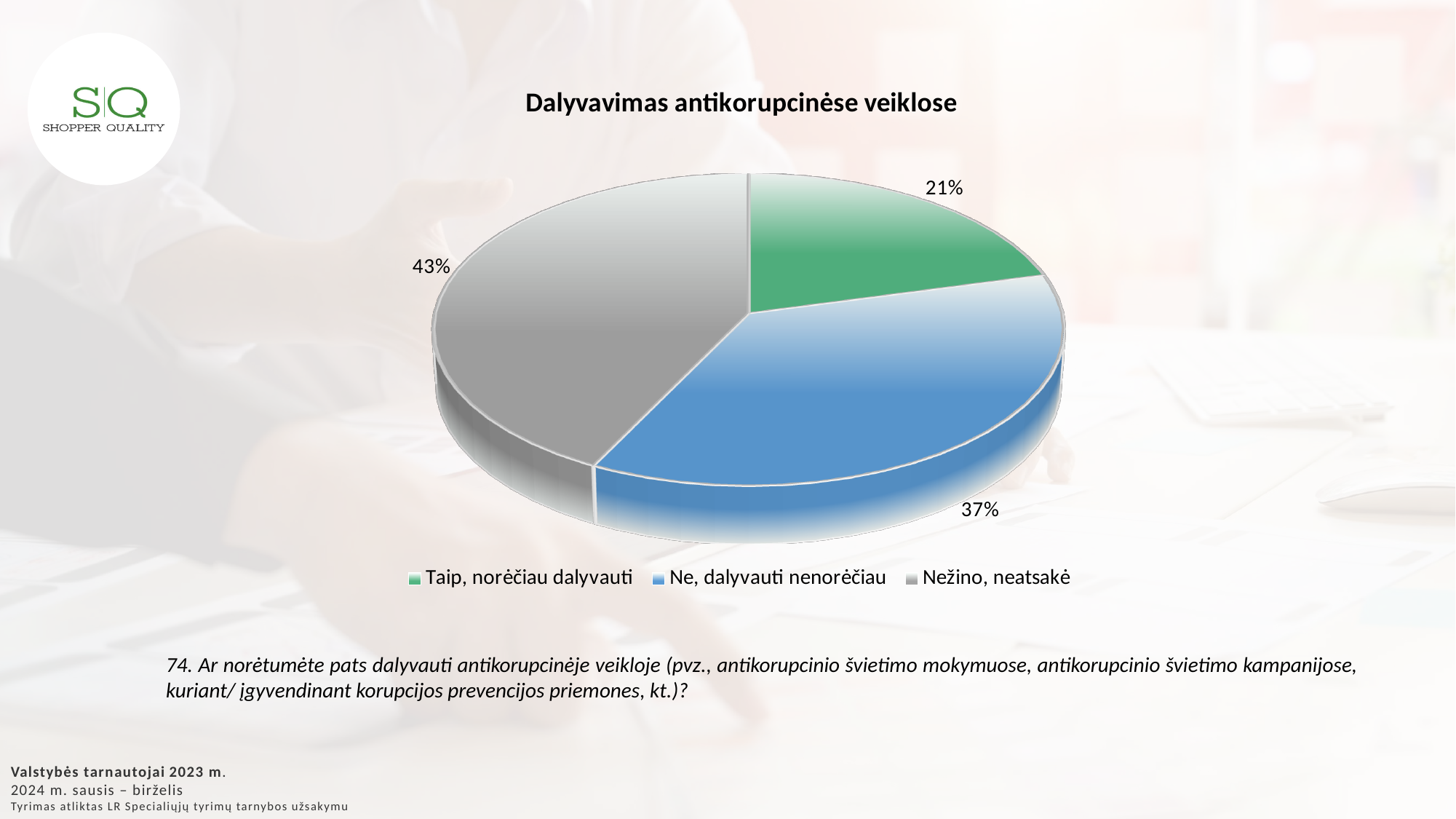
What share of respondents answered "Ne, dalyvauti nenorėčiau"? 37% Which is larger: the share for "Ne, dalyvauti nenorėčiau" or the share for "Taip, norėčiau dalyvauti"? Ne, dalyvauti nenorėčiau What is the difference in percentage points between "Nežino, neatsakė" and "Ne, dalyvauti nenorėčiau"? 6 percentage points What type of chart is shown on the slide? Pie chart What is the difference in percentage points between "Nežino, neatsakė" and "Taip, norėčiau dalyvauti"? 22 percentage points What share of respondents answered "Nežino, neatsakė"? 43% Which category has the largest share of the pie? Nežino, neatsakė What is the title of the chart? Dalyvavimas antikorupcinėse veiklose How many categories does the pie chart show? 3 What share of respondents answered "Taip, norėčiau dalyvauti"? 21% What colour is the slice for "Ne, dalyvauti nenorėčiau"? Blue Which category has the smallest share of the pie? Taip, norėčiau dalyvauti